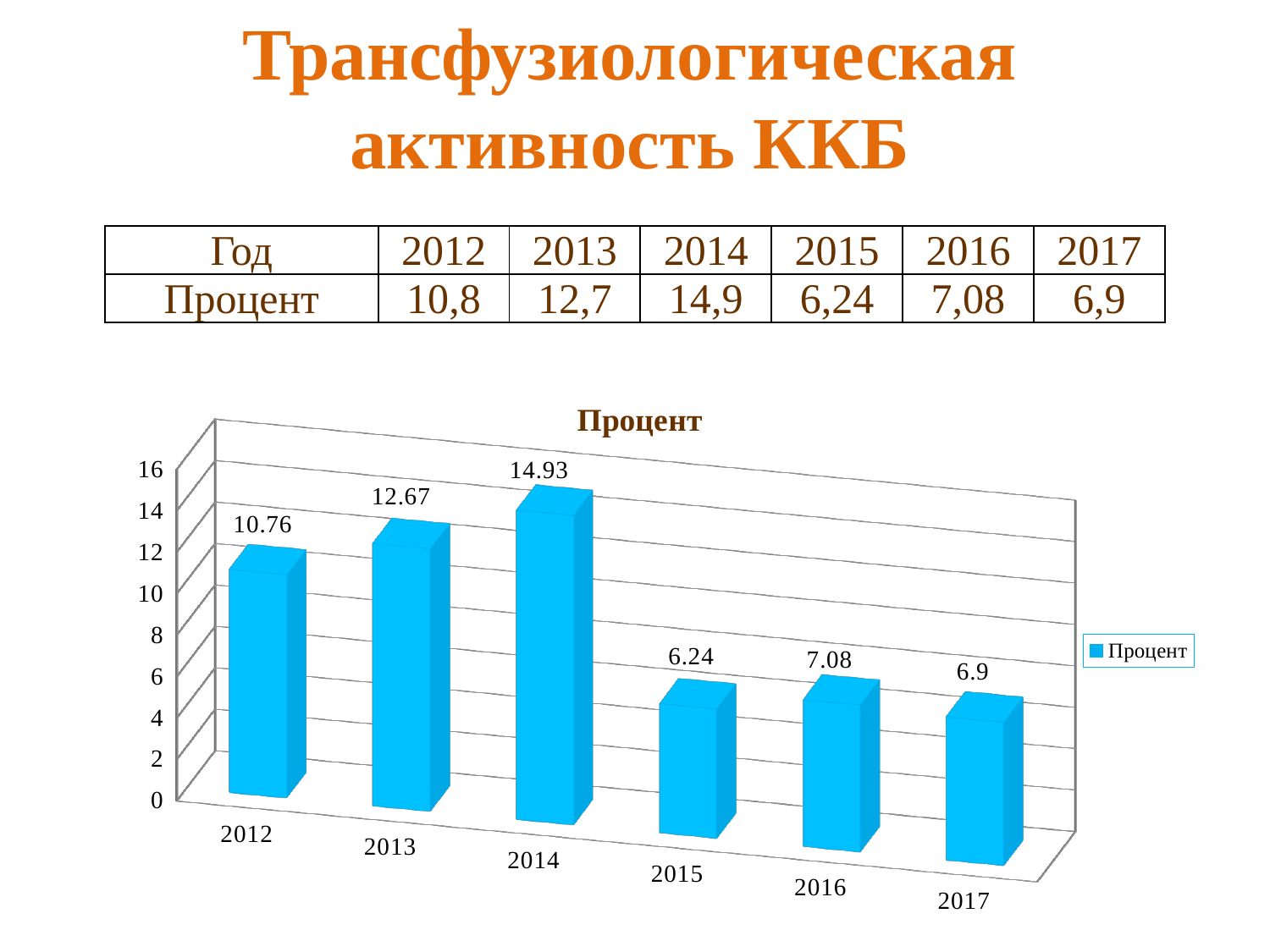
What kind of chart is shown on the slide? bar chart Which is larger, the value for 2013 or the value for 2016? 2013 How many years are shown on the x axis of the chart? 6 Is the value for 2015 greater or less than 8? less Which year has the lowest value in the chart? 2015 What is the difference between the values for 2014 and 2012? 4.17 What is the value shown for 2012 in the chart? 10.76 What is the value shown for 2014 in the chart? 14.93 What is the value shown for 2017 in the chart? 6.9 What is the difference between the values for 2016 and 2015? 0.84 Which year has the highest value in the chart? 2014 What is the title of the chart? Процент